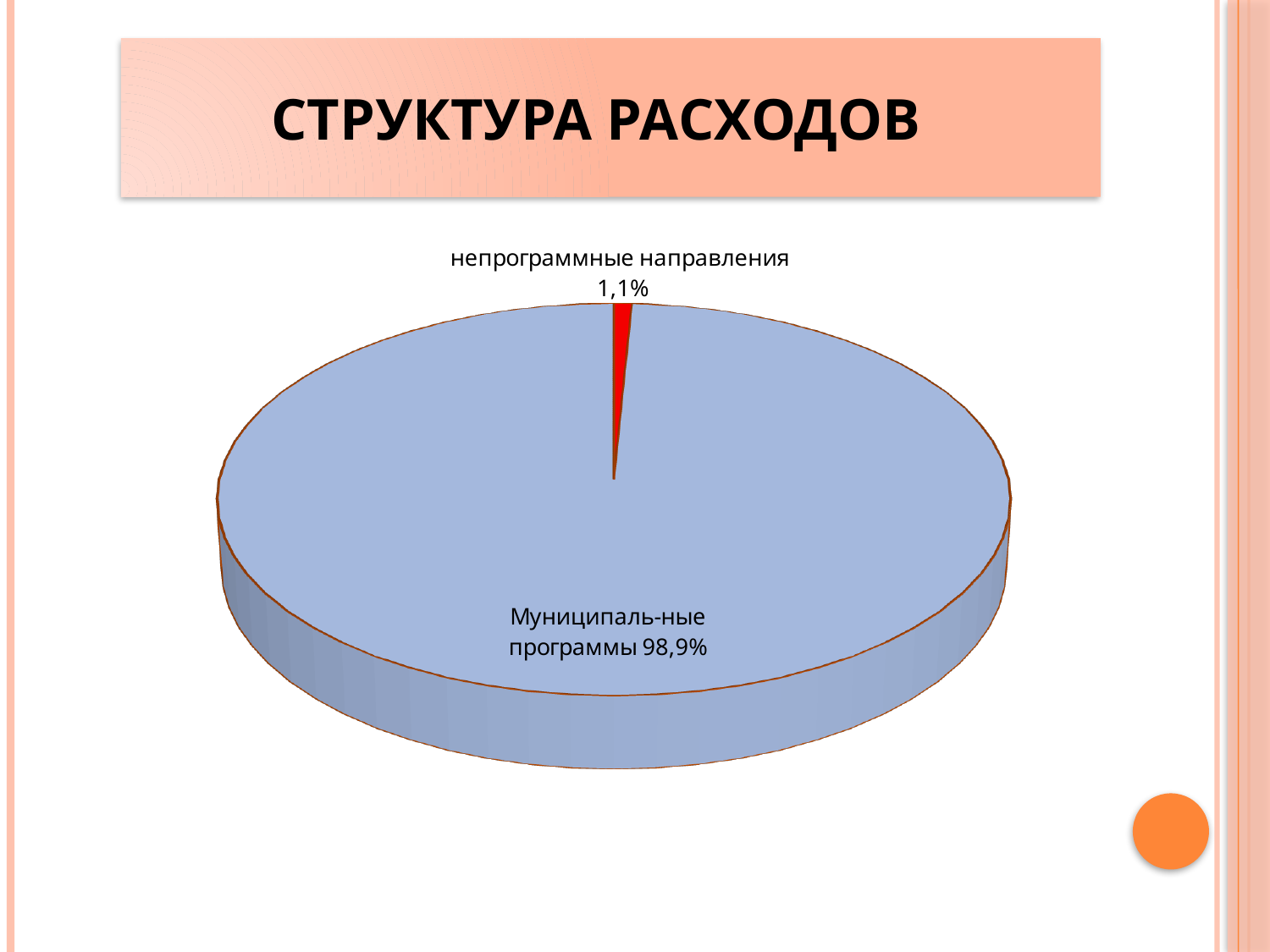
What colour is the slice for "непрограммные направления"? red Which slice of the pie is the smallest? непрограммные направления What is the title of the slide containing the chart? СТРУКТУРА РАСХОДОВ What kind of chart is shown on the slide? pie chart What is the difference in percentage points between "Муниципальные программы" and "непрограммные направления"? 97,8 What share of the pie does "непрограммные направления" take? 1,1% Which is larger: the share for "непрограммные направления" or the share for "Муниципальные программы"? Муниципальные программы Which slice of the pie is the largest? Муниципальные программы What share of the pie does "Муниципальные программы" take? 98,9% How many slices does the pie chart have? 2